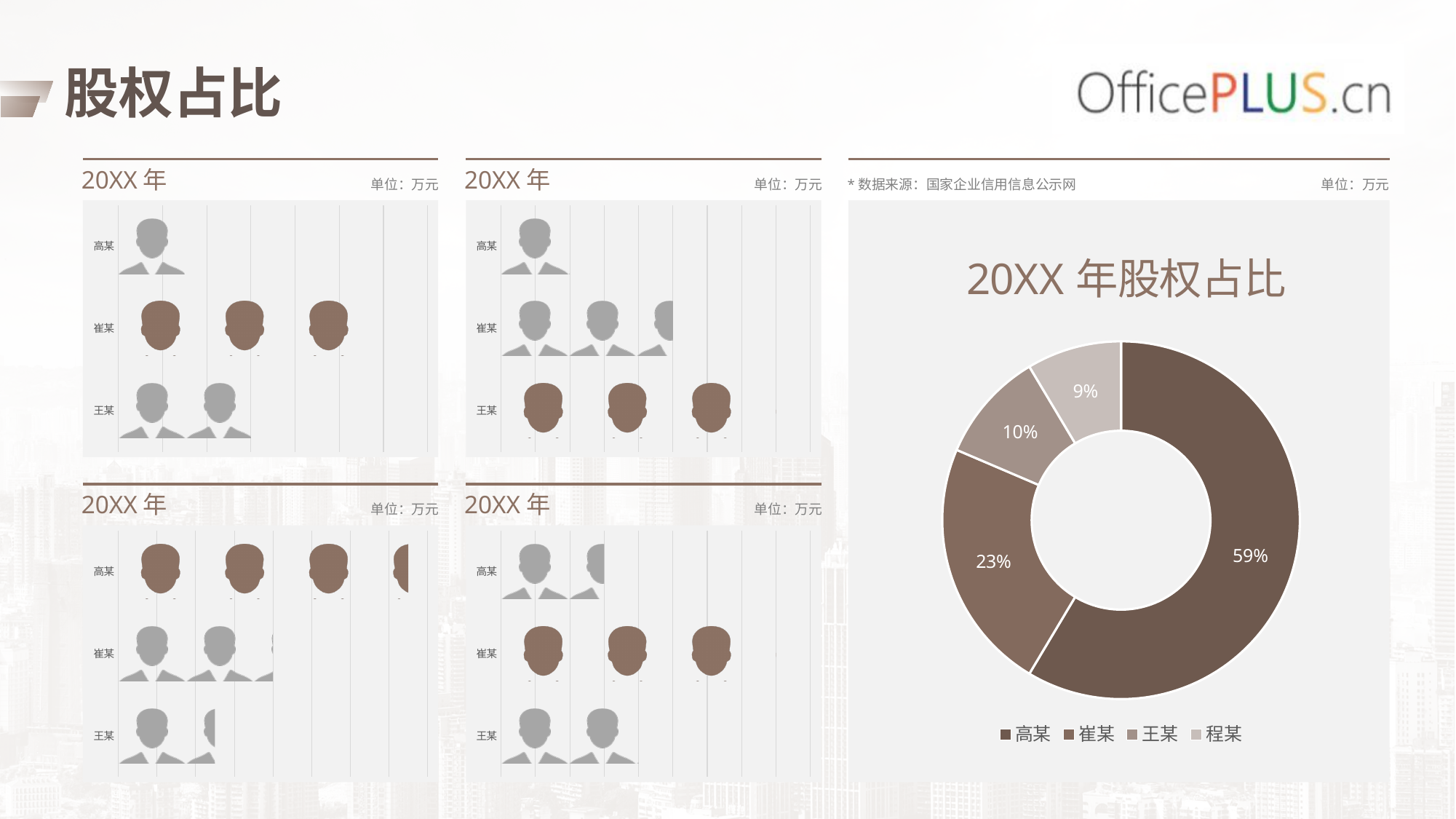
In the donut chart titled 20XX 年股权占比, which shareholder has the smallest share? 程某 In the donut chart titled 20XX 年股权占比, how many percentage points larger is 高某's share than 崔某's share? 36% In the donut chart titled 20XX 年股权占比, what share does 崔某 hold? 23% In the donut chart titled 20XX 年股权占比, how many shareholders (slices) are shown? 4 How many entries does the legend of the chart titled 20XX 年股权占比 list? 4 In the donut chart titled 20XX 年股权占比, what share does 王某 hold? 10% What kind of chart is the one titled 20XX 年股权占比 on the right of the slide? Donut (pie) chart In the donut chart titled 20XX 年股权占比, who holds the larger share, 王某 or 程某? 王某 In the donut chart titled 20XX 年股权占比, what share does 高某 hold? 59% What is the title of the chart on the right side of the slide? 20XX 年股权占比 In the donut chart titled 20XX 年股权占比, which shareholder has the largest share? 高某 In the donut chart titled 20XX 年股权占比, what share does 程某 hold? 9%